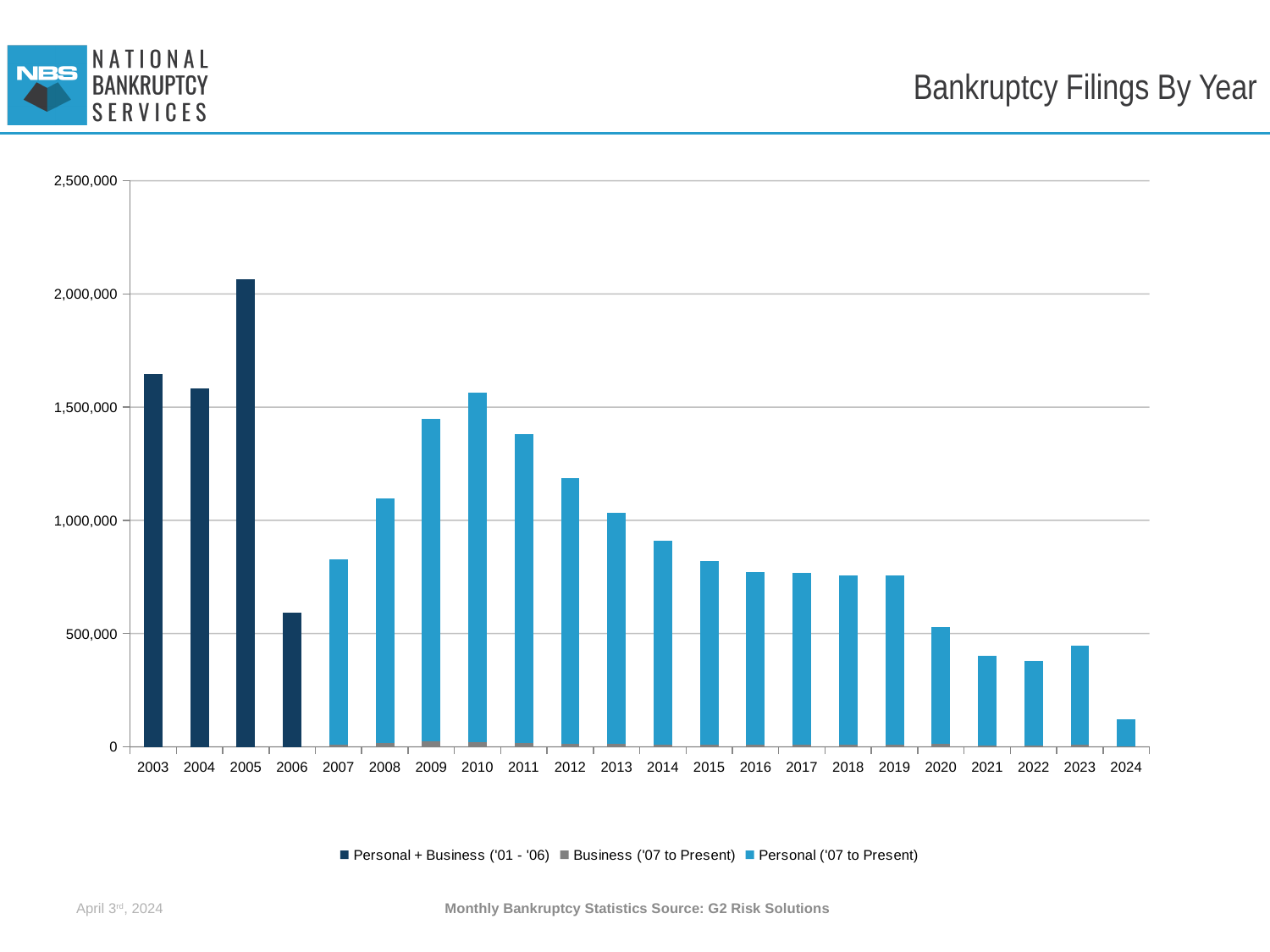
Which year has the larger total filings, 2009 or 2010? 2010 Is the value for 2005 greater or less than 2,000,000? greater Which year has the highest total bankruptcy filings? 2005 Do the total filings rise or fall from 2010 to 2021? fall How many series does the legend list? 3 Which year has the lowest total bankruptcy filings? 2024 How many years are shown on the x axis of the chart? 22 Is the value for 2014 greater or less than 1,000,000? less What kind of chart is shown on the slide? bar chart Is the value for 2008 greater or less than 1,000,000? greater What is the title of the chart? Bankruptcy Filings By Year